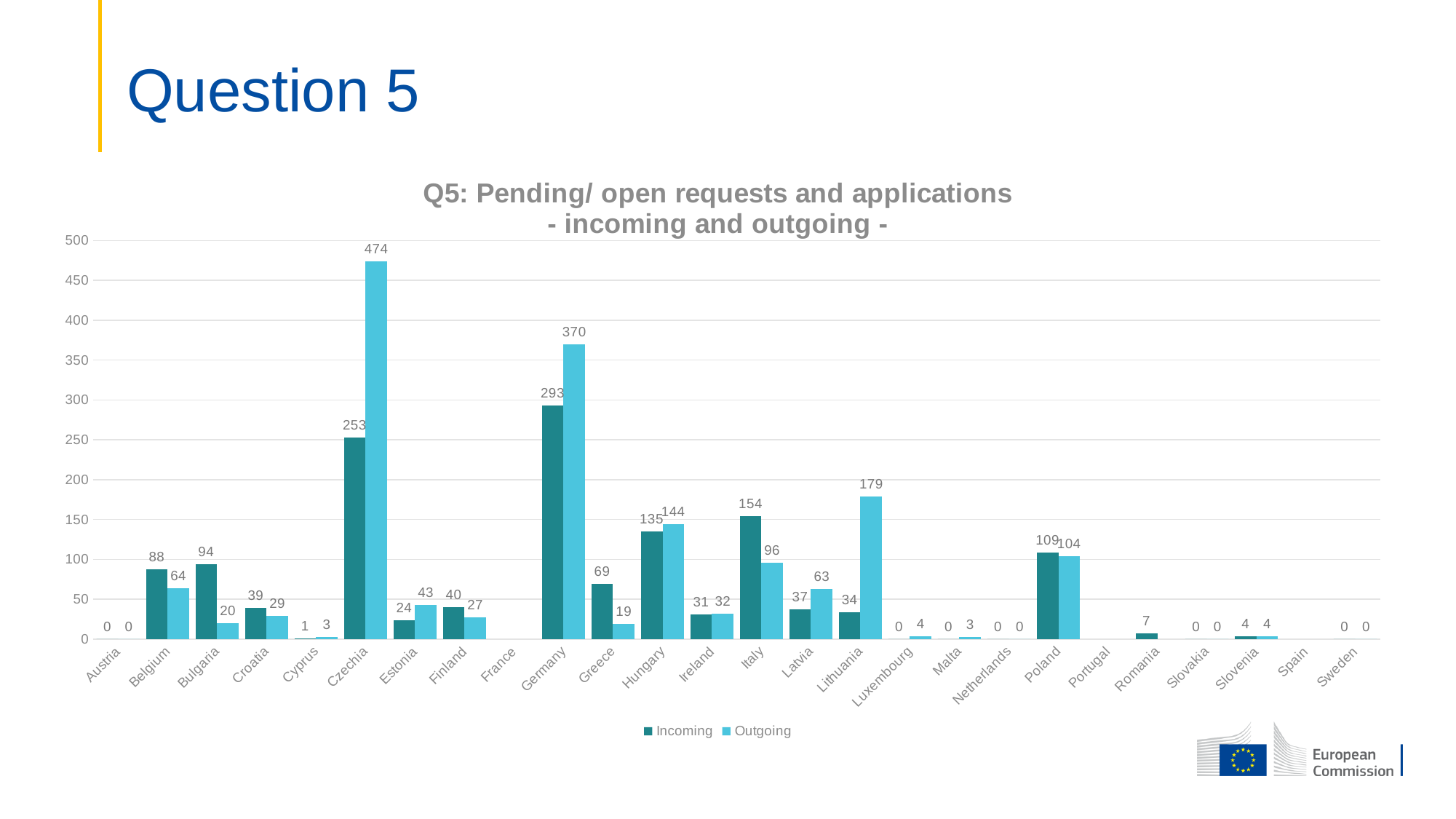
What is the Outgoing value for Lithuania? 179 Which country has the highest Incoming value? Germany Which country has the highest Outgoing value? Czechia What kind of chart is shown on the slide? bar chart How many series does the legend list? 2 What is the Outgoing value for Czechia? 474 What is the Incoming value for Germany? 293 What is the title of the chart? Q5: Pending/ open requests and applications - incoming and outgoing - How many countries are shown on the x axis? 26 Is the Outgoing value for Germany greater or less than 350? greater What is the difference between the Outgoing and Incoming values for Czechia? 221 Which is larger for Italy, the Incoming value or the Outgoing value? Incoming